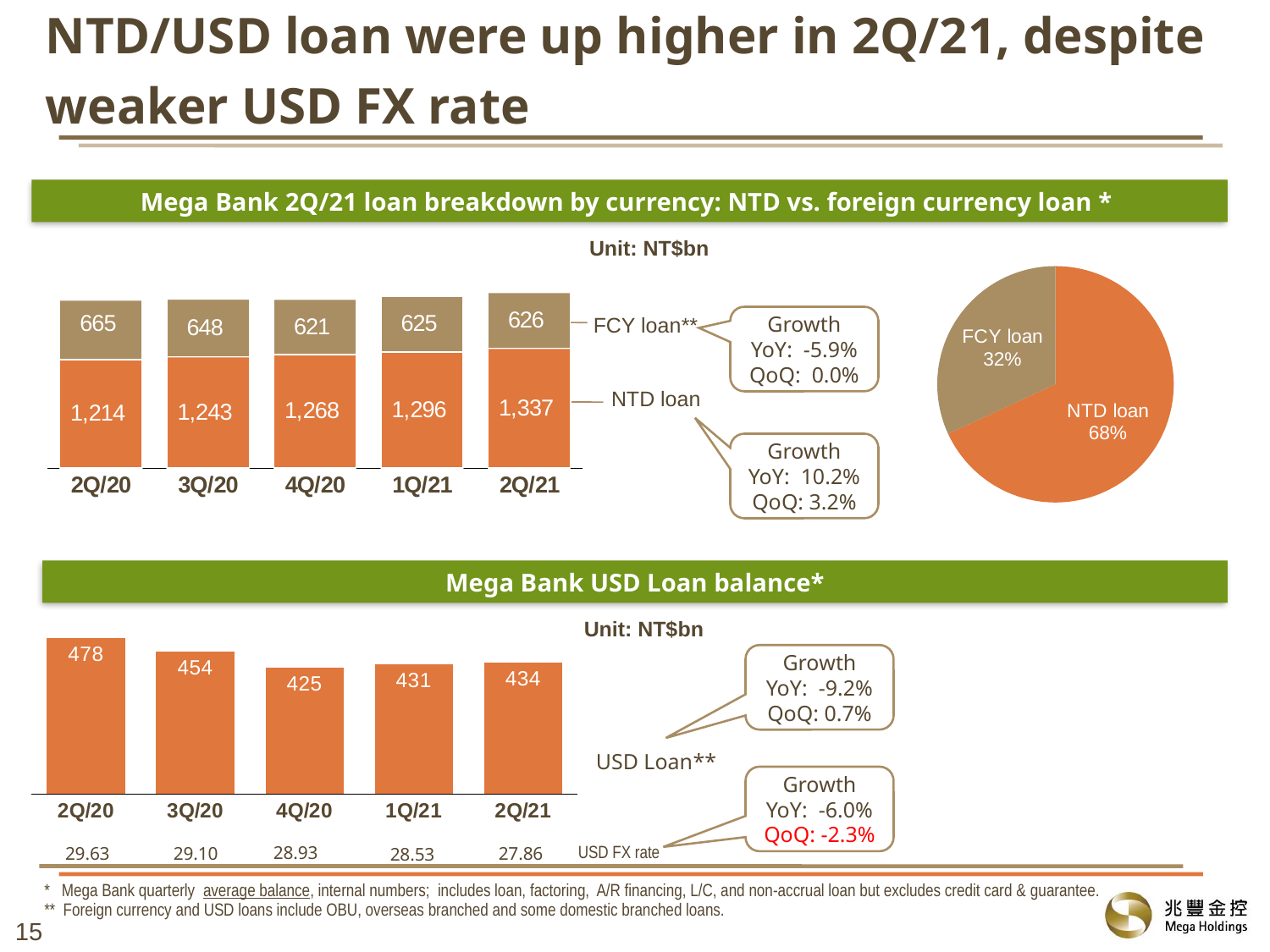
In the 'Mega Bank USD Loan balance' chart, what is the USD loan value for 4Q/20? 425 In the pie chart on the slide, what share of loans is FCY loan? 32% In the 'Mega Bank USD Loan balance' chart, what is the difference between the 2Q/20 and 2Q/21 USD loan values? 44 What kind of chart is the 'Mega Bank USD Loan balance' chart? bar chart In the 'Mega Bank 2Q/21 loan breakdown by currency' chart, what is the FCY loan value for 4Q/20? 621 In the 'Mega Bank USD Loan balance' chart, which quarter has the highest USD loan balance? 2Q/20 In the pie chart on the slide, which slice is larger, NTD loan or FCY loan? NTD loan In the 'Mega Bank 2Q/21 loan breakdown by currency' chart, do the NTD loan values rise or fall from 2Q/20 to 2Q/21? rise In the 'Mega Bank 2Q/21 loan breakdown by currency' chart, what is the total of the stacked bar for 2Q/20? 1,879 In the 'Mega Bank 2Q/21 loan breakdown by currency' chart, which quarter has the highest NTD loan value? 2Q/21 In the 'Mega Bank 2Q/21 loan breakdown by currency' chart, what is the NTD loan value for 2Q/21? 1,337 In the 'Mega Bank 2Q/21 loan breakdown by currency' chart, how many quarters are shown on the x axis? 5